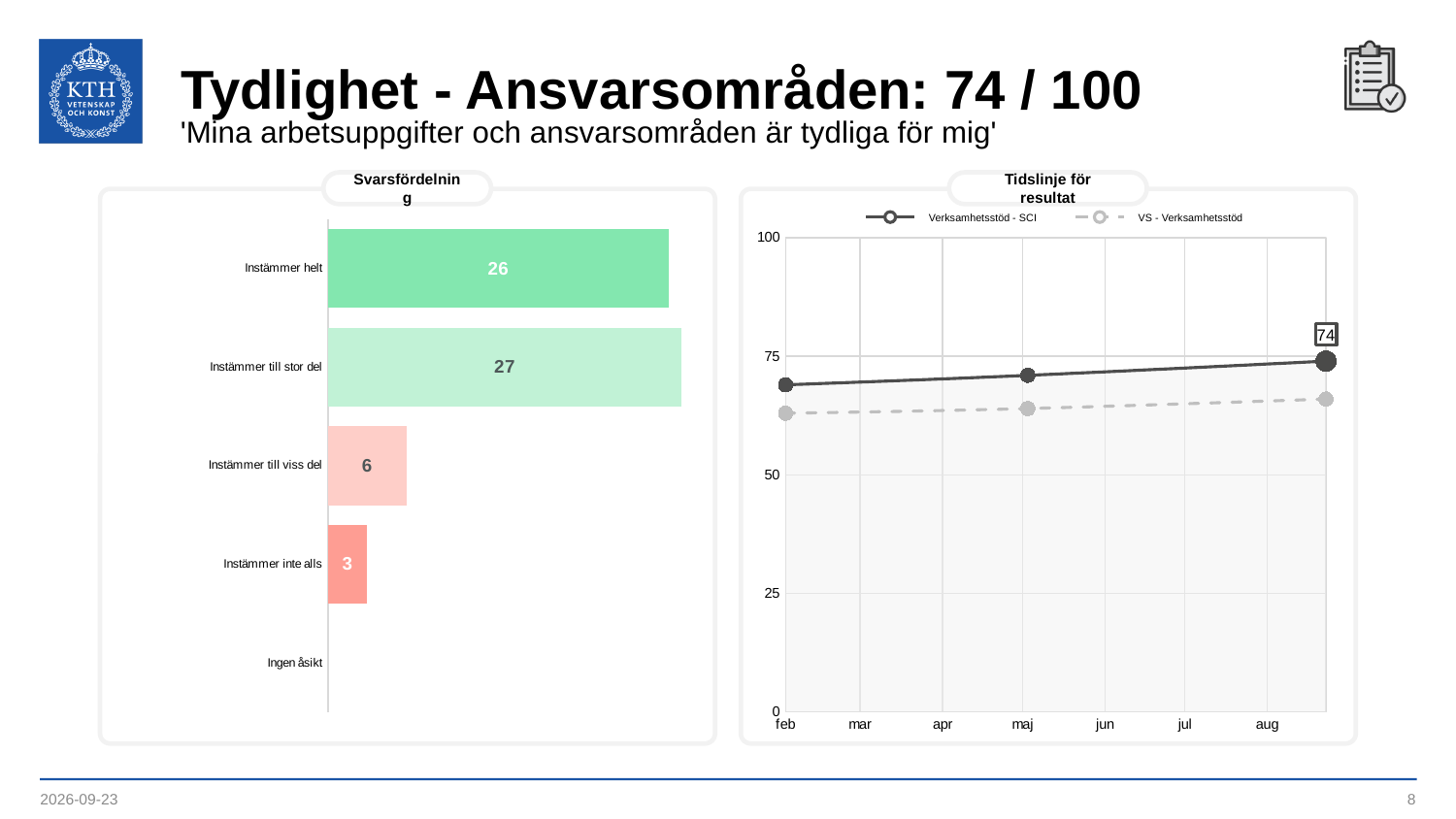
In the Svarsfördelning chart, what is the difference between 'Instämmer helt' and 'Instämmer till viss del'? 20 In the Tidslinje för resultat chart, is the value for 'VS - Verksamhetsstöd' in maj greater or less than 75? less In the Svarsfördelning chart, what is the value for 'Instämmer till stor del'? 27 In the Svarsfördelning chart, how many categories are listed on the axis? 5 In the Svarsfördelning chart, what is the value for 'Instämmer till viss del'? 6 In the Tidslinje för resultat chart, what is the labelled value of the last point for 'Verksamhetsstöd - SCI'? 74 In the Svarsfördelning chart, which is larger: 'Instämmer helt' or 'Instämmer till stor del'? Instämmer till stor del In the Svarsfördelning chart, what is the value for 'Instämmer inte alls'? 3 How many series does the legend of the Tidslinje för resultat chart list? 2 What kind of chart is the Svarsfördelning chart? Bar chart In the Svarsfördelning chart, what is the value for 'Instämmer helt'? 26 In the Svarsfördelning chart, which category has the highest value? Instämmer till stor del